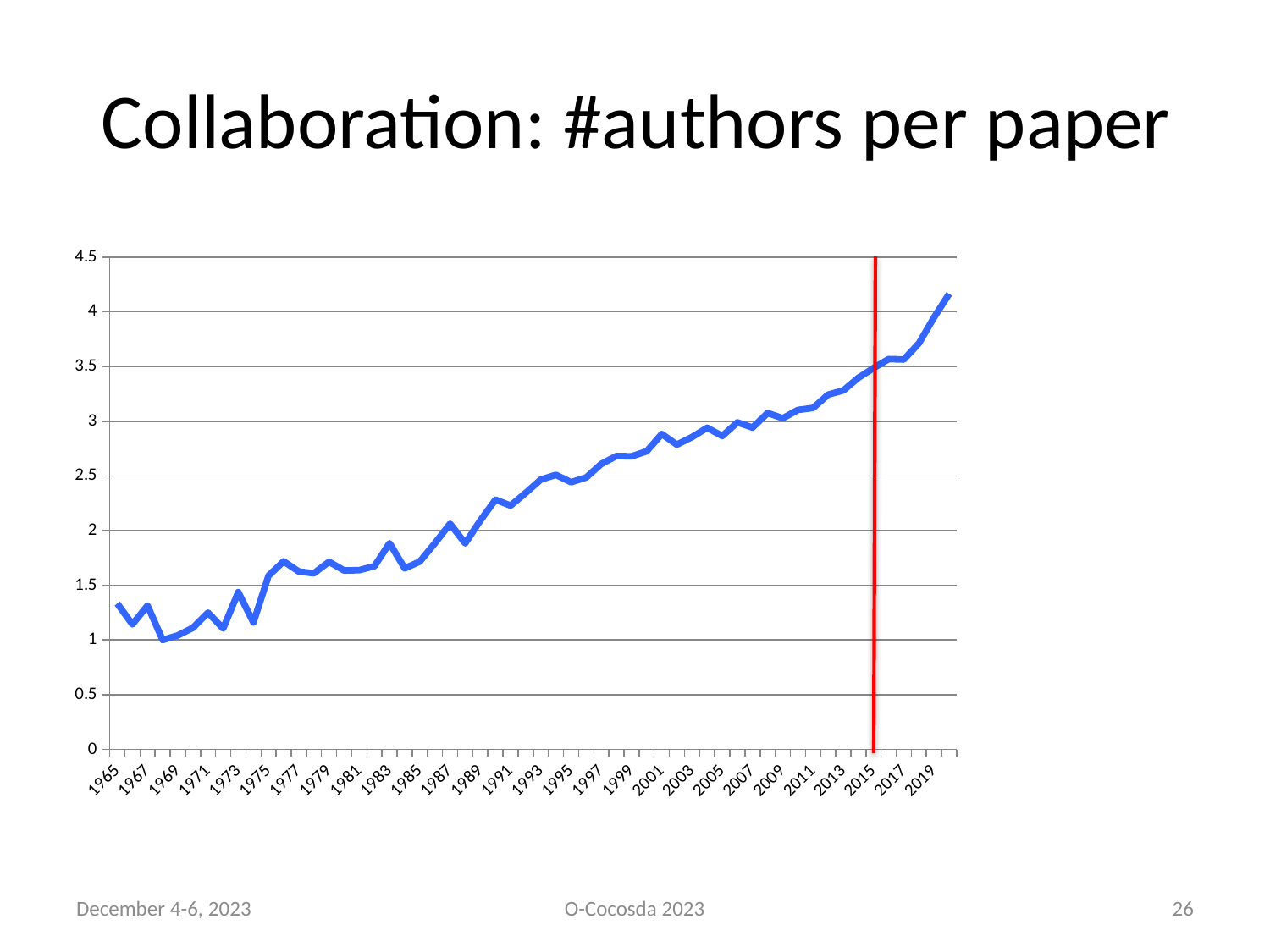
Is the value for 1985 greater or less than 1.5? greater Is the value for 1991 greater or less than 2.5? less Which year has the larger value, 1975 or 1985? 1985 Which year has the lowest number of authors per paper? 1968 Is the value for 2013 greater or less than 3? greater What is the title of the chart on the slide? Collaboration: #authors per paper What is the highest value shown on the vertical axis? 4.5 What kind of chart is shown on the slide? line chart Overall, do the values rise or fall from 1965 to the end of the series? rise